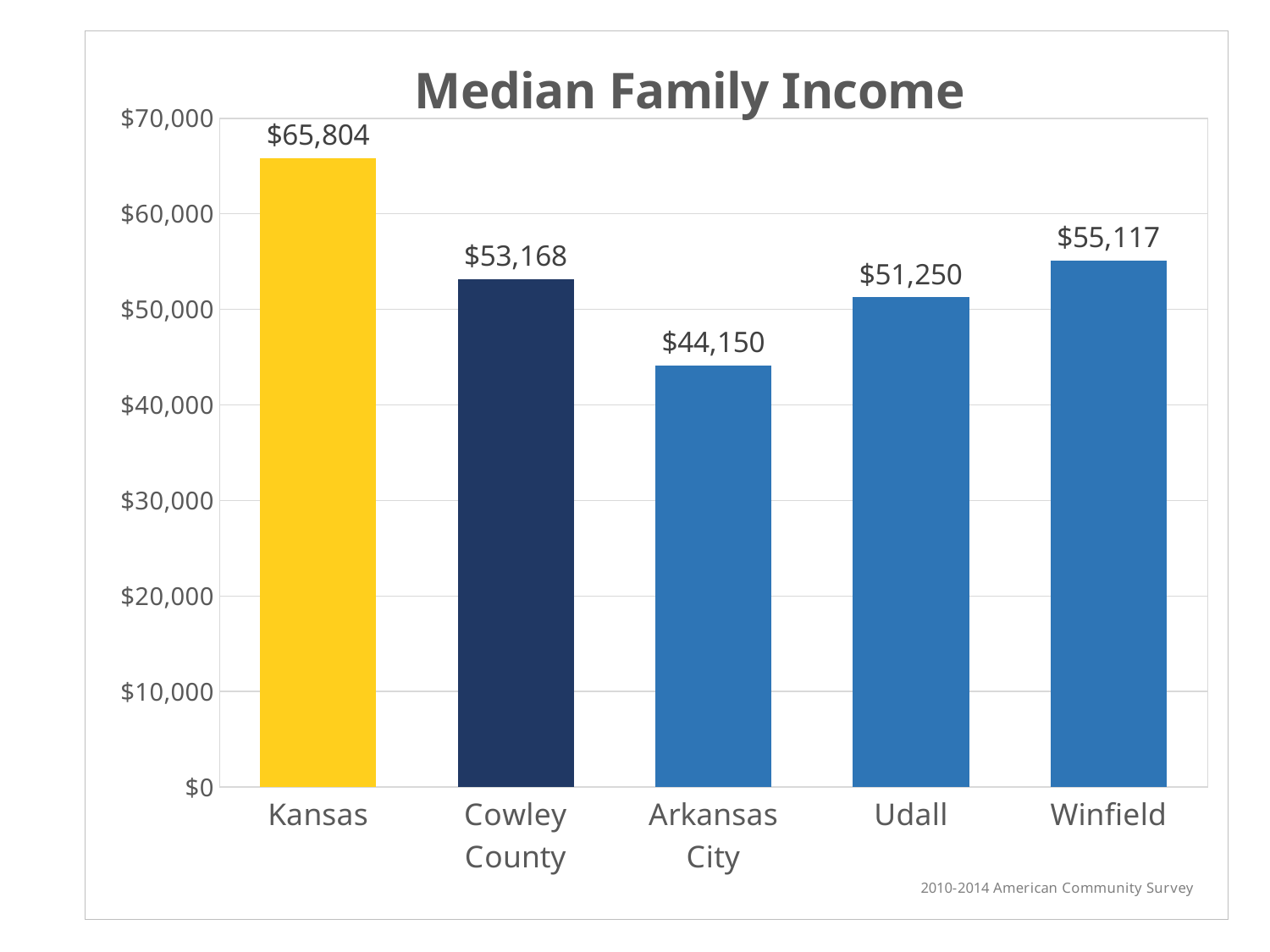
What is the difference between the median family income of Kansas and Cowley County? $12,636 What is the median family income for Cowley County? $53,168 Which has a higher median family income, Winfield or Udall? Winfield Is the value for Arkansas City greater or less than $50,000? less What is the median family income for Kansas? $65,804 What is the median family income for Udall? $51,250 What is the median family income for Arkansas City? $44,150 Which category has the highest median family income? Kansas What type of chart is shown on the slide? Bar chart How many categories are shown in the chart? 5 Which category has the lowest median family income? Arkansas City What is the median family income for Winfield? $55,117